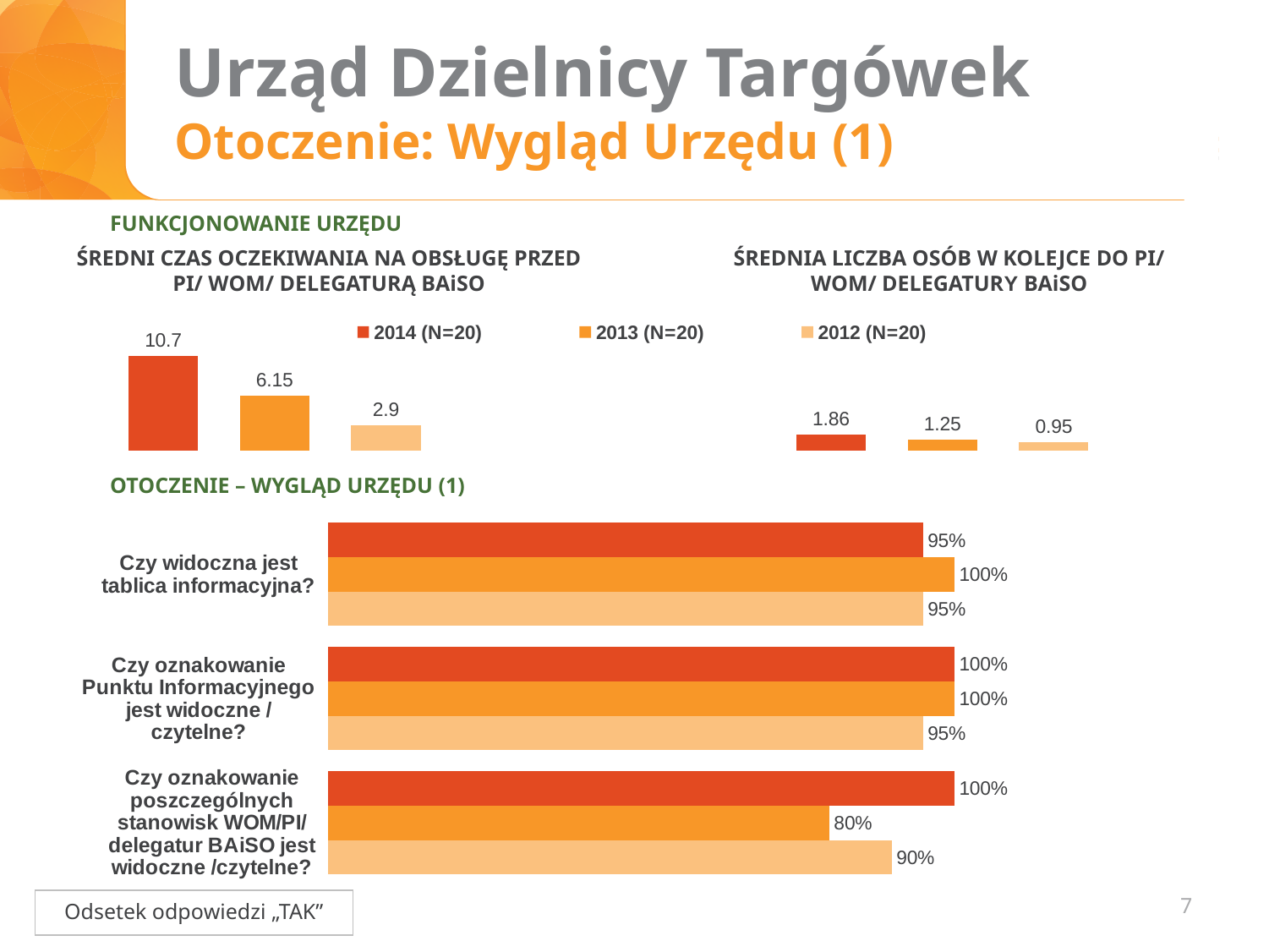
In the chart 'ŚREDNIA LICZBA OSÓB W KOLEJCE DO PI/ WOM/ DELEGATURY BAiSO', what is the value for 2013? 1.25 In the chart 'ŚREDNI CZAS OCZEKIWANIA NA OBSŁUGĘ PRZED PI/ WOM/ DELEGATURĄ BAiSO', what is the value for 2014? 10.7 In the chart 'ŚREDNIA LICZBA OSÓB W KOLEJCE DO PI/ WOM/ DELEGATURY BAiSO', which year has the lowest value? 2012 What kind of chart is 'OTOCZENIE – WYGLĄD URZĘDU (1)'? Bar chart In the chart 'OTOCZENIE – WYGLĄD URZĘDU (1)', what is the 2013 value for 'Czy oznakowanie poszczególnych stanowisk WOM/PI/ delegatur BAiSO jest widoczne /czytelne?'? 80% In the chart 'ŚREDNIA LICZBA OSÓB W KOLEJCE DO PI/ WOM/ DELEGATURY BAiSO', what is the difference between the 2014 and 2012 values? 0.91 In the chart 'OTOCZENIE – WYGLĄD URZĘDU (1)', what is the 2013 value for 'Czy widoczna jest tablica informacyjna?'? 100% In the chart 'ŚREDNI CZAS OCZEKIWANIA NA OBSŁUGĘ PRZED PI/ WOM/ DELEGATURĄ BAiSO', what is the difference between the 2014 and 2013 values? 4.55 In the chart 'OTOCZENIE – WYGLĄD URZĘDU (1)', for 'Czy oznakowanie poszczególnych stanowisk WOM/PI/ delegatur BAiSO jest widoczne /czytelne?', which is larger: the 2014 value or the 2012 value? 2014 How many series does the legend at the top of the slide list? 3 In the chart 'ŚREDNI CZAS OCZEKIWANIA NA OBSŁUGĘ PRZED PI/ WOM/ DELEGATURĄ BAiSO', which year has the highest value? 2014 In the chart 'ŚREDNI CZAS OCZEKIWANIA NA OBSŁUGĘ PRZED PI/ WOM/ DELEGATURĄ BAiSO', what is the value for 2012? 2.9